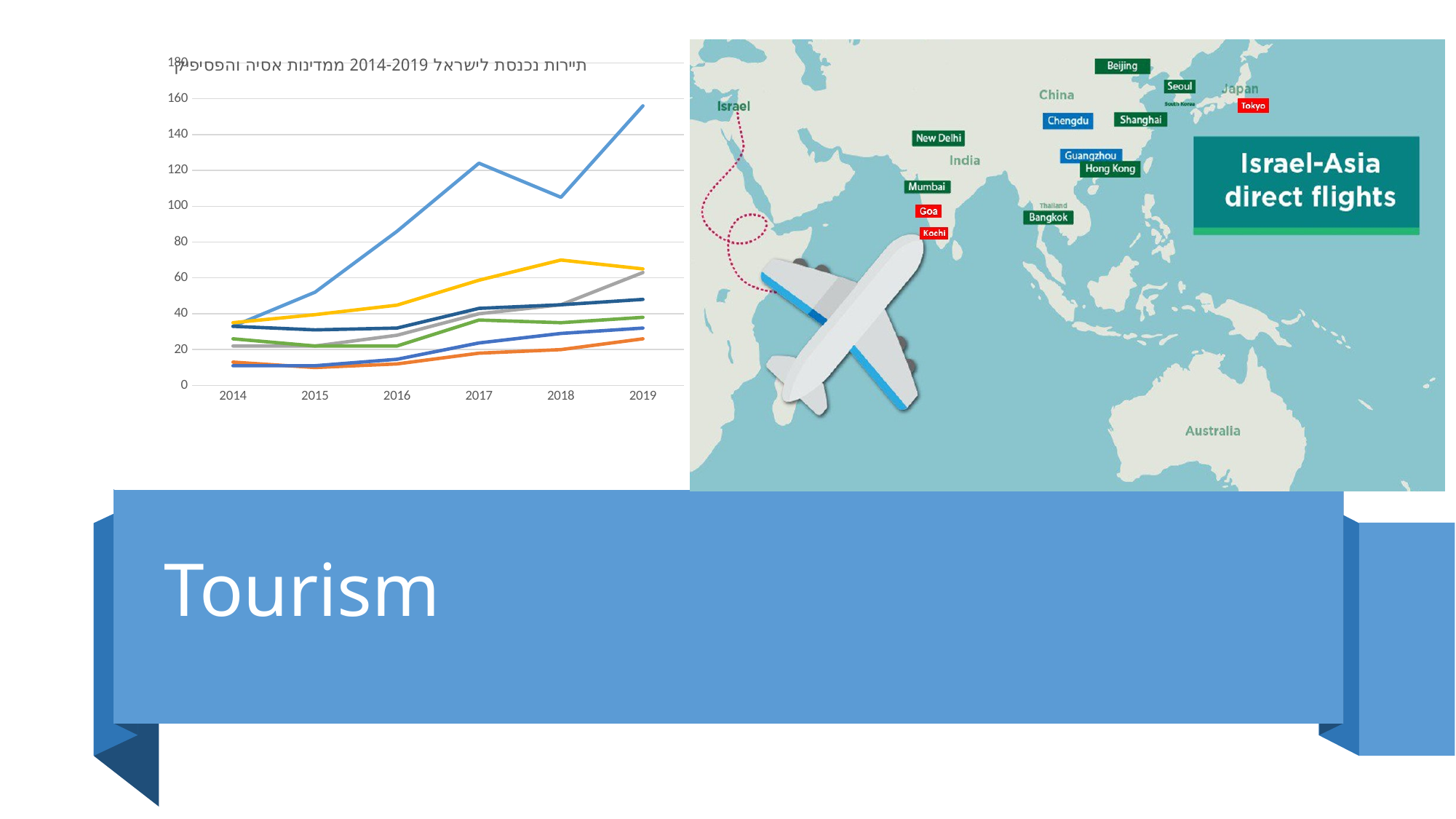
In which year does the light blue line reach its highest value? 2019 Does the light blue line overall rise or fall from 2014 to 2019? rise In which year does the light blue line have its lowest value? 2014 What kind of chart is shown on the left of the slide? line chart Is the value of the yellow line in 2018 greater or less than 60? greater What is the highest value shown on the y axis of the line chart? 180 What is the first year shown on the x axis of the line chart? 2014 What is the last year shown on the x axis of the line chart? 2019 Is the value of the light blue line in 2017 greater or less than 100? greater How many years are shown along the x axis of the line chart? 6 Is the value of the light blue line in 2016 greater or less than 100? less